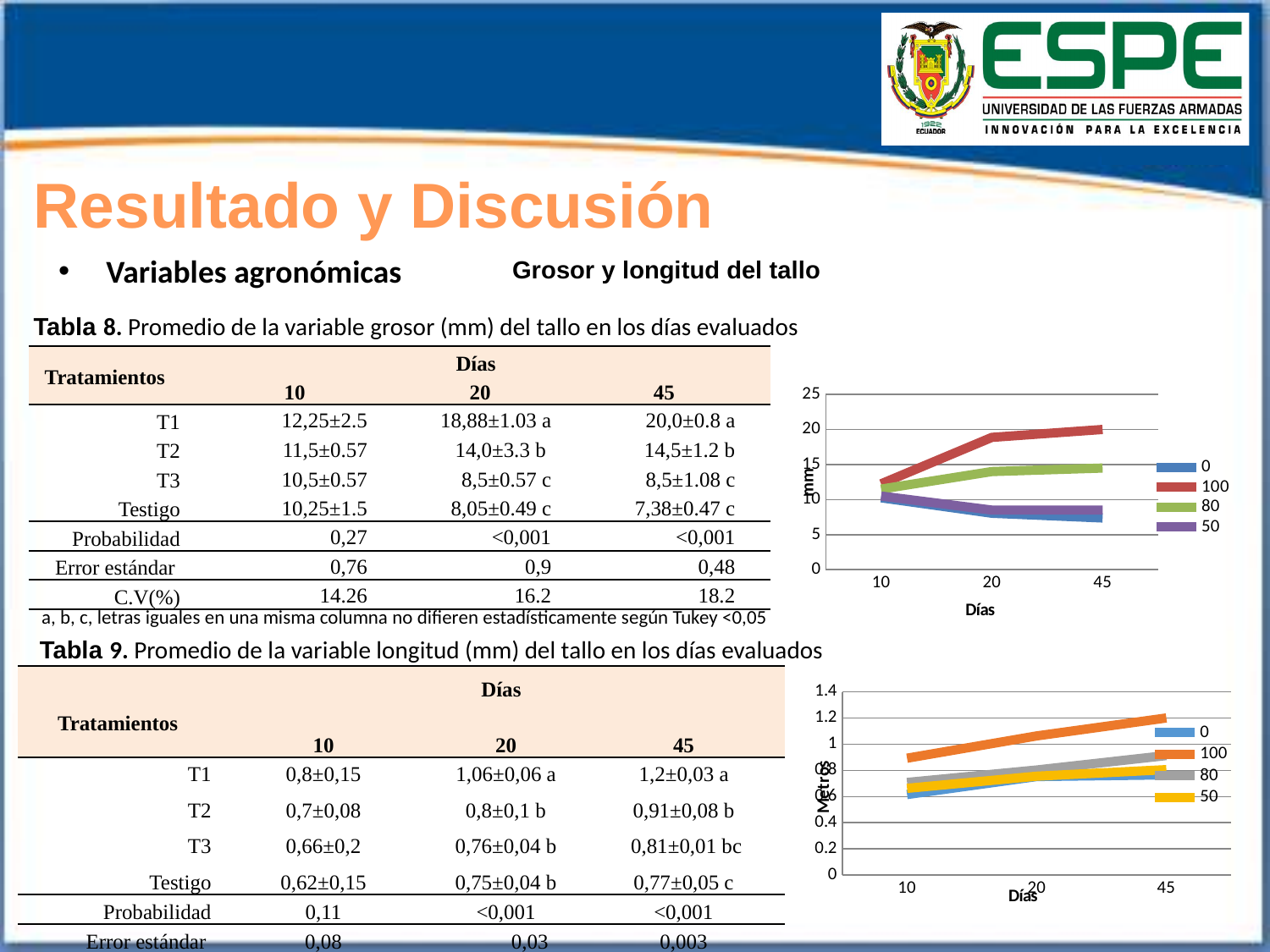
In the top chart, which series has the highest value at day 45? 100 In the top chart, is the value for series 0 at day 45 greater or less than 10? less How many points are shown on the x axis of the bottom chart? 3 How many series does the legend of the top chart list? 4 In the bottom chart, is the value for series 50 at day 45 greater or less than 1? less In the bottom chart, is the value for series 100 at day 45 greater or less than 1? greater What kind of chart is the top chart on the right of the slide? line chart In the bottom chart, which series has the highest value at day 45? 100 What is the y-axis title of the bottom chart? Metros In the top chart, does the series 0 rise or fall from day 10 to day 45? fall In the top chart, does the series 100 rise or fall from day 10 to day 45? rise